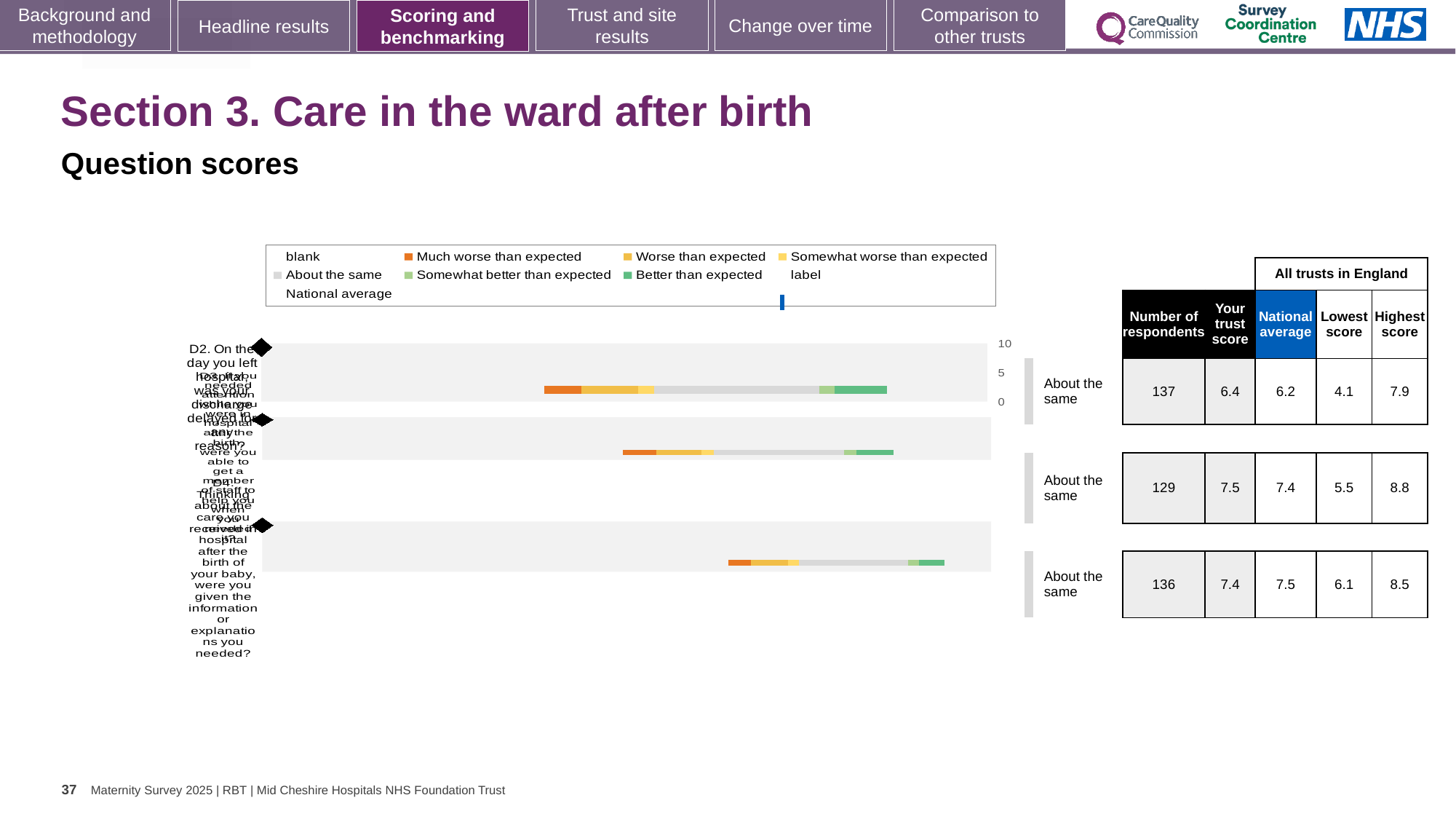
What benchmark label is shown next to each of the three bars? About the same What is the highest tick value shown on the chart's axis? 10 What kind of chart is shown on the slide? bar chart How many horizontal bars are plotted in the chart? 3 In the table beside the chart, what is 'Your trust score' for the first row (question D2)? 6.4 Which row of the table has the lowest 'Lowest score' value? the first row (4.1) For the first row (question D2), what is the difference between the highest score (7.9) and the lowest score (4.1)? 3.8 In the table beside the chart, what is the national average for the first row (question D2)? 6.2 What colour does the legend use for 'Much worse than expected'? orange Which row of the table has the highest 'Your trust score'? the second row (7.5) For the first row (question D2), which is larger: the trust score or the national average? the trust score (6.4) In the table beside the chart, what is the number of respondents for the first row (question D2 about discharge being delayed)? 137